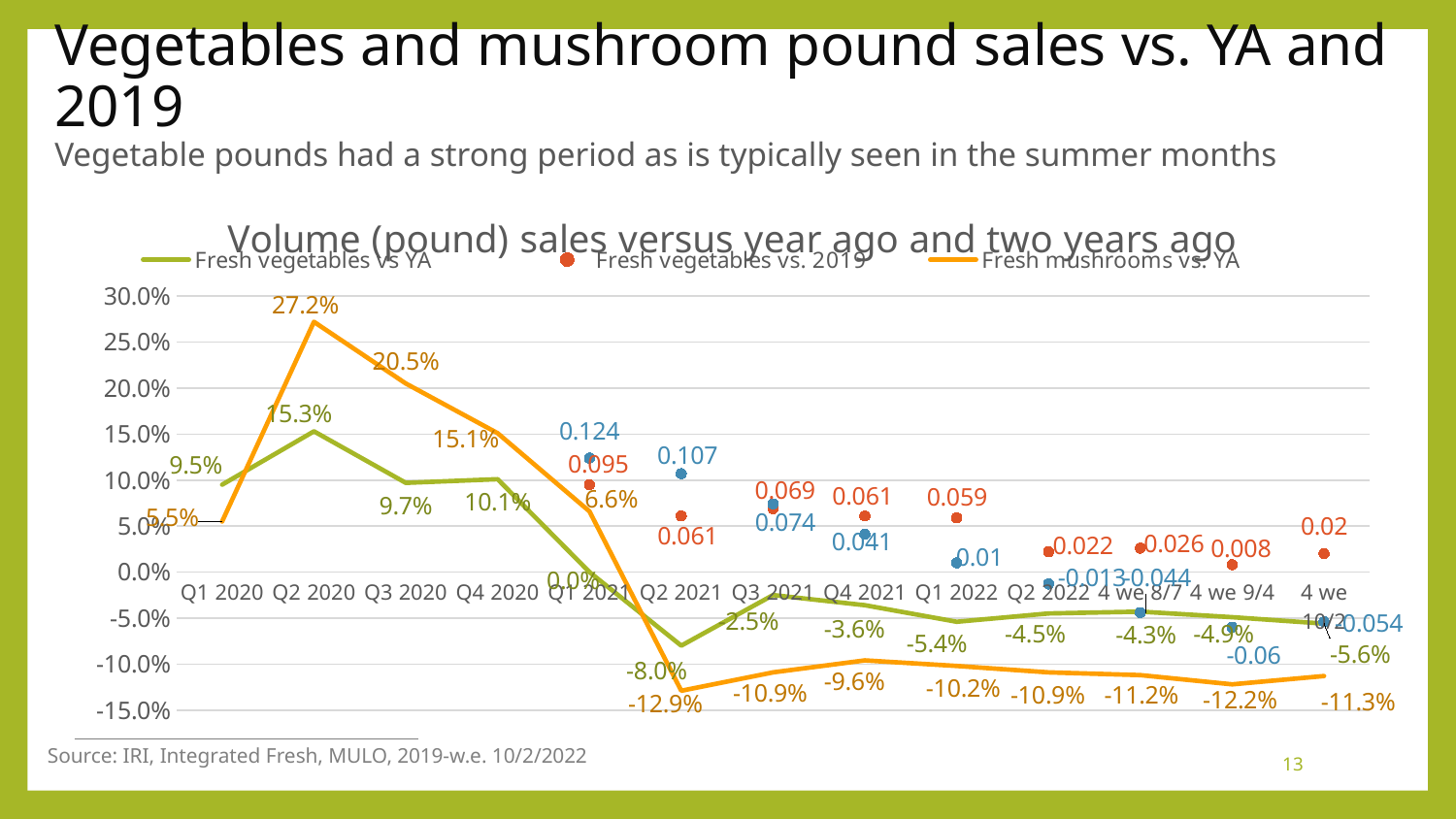
What is the value for Fresh vegetables vs. 2019 in Q1 2022? 0.059 In which period is Fresh vegetables vs YA highest? Q2 2020 What is the difference between Fresh mushrooms vs. YA and Fresh vegetables vs YA in Q2 2020? 11.9 percentage points In Q1 2020, which is larger: Fresh vegetables vs YA or Fresh mushrooms vs. YA? Fresh vegetables vs YA What is the value for Fresh vegetables vs YA in the 4 we 10/2 period? -5.6% What kind of chart is shown on the slide? Line chart In which period is Fresh mushrooms vs. YA lowest? Q2 2021 How many series does the legend list? 3 What is the value for Fresh mushrooms vs. YA in Q2 2020? 27.2% What is the value for Fresh vegetables vs YA in Q2 2021? -8.0% In which period is Fresh mushrooms vs. YA highest? Q2 2020 How many periods are shown on the x axis? 13